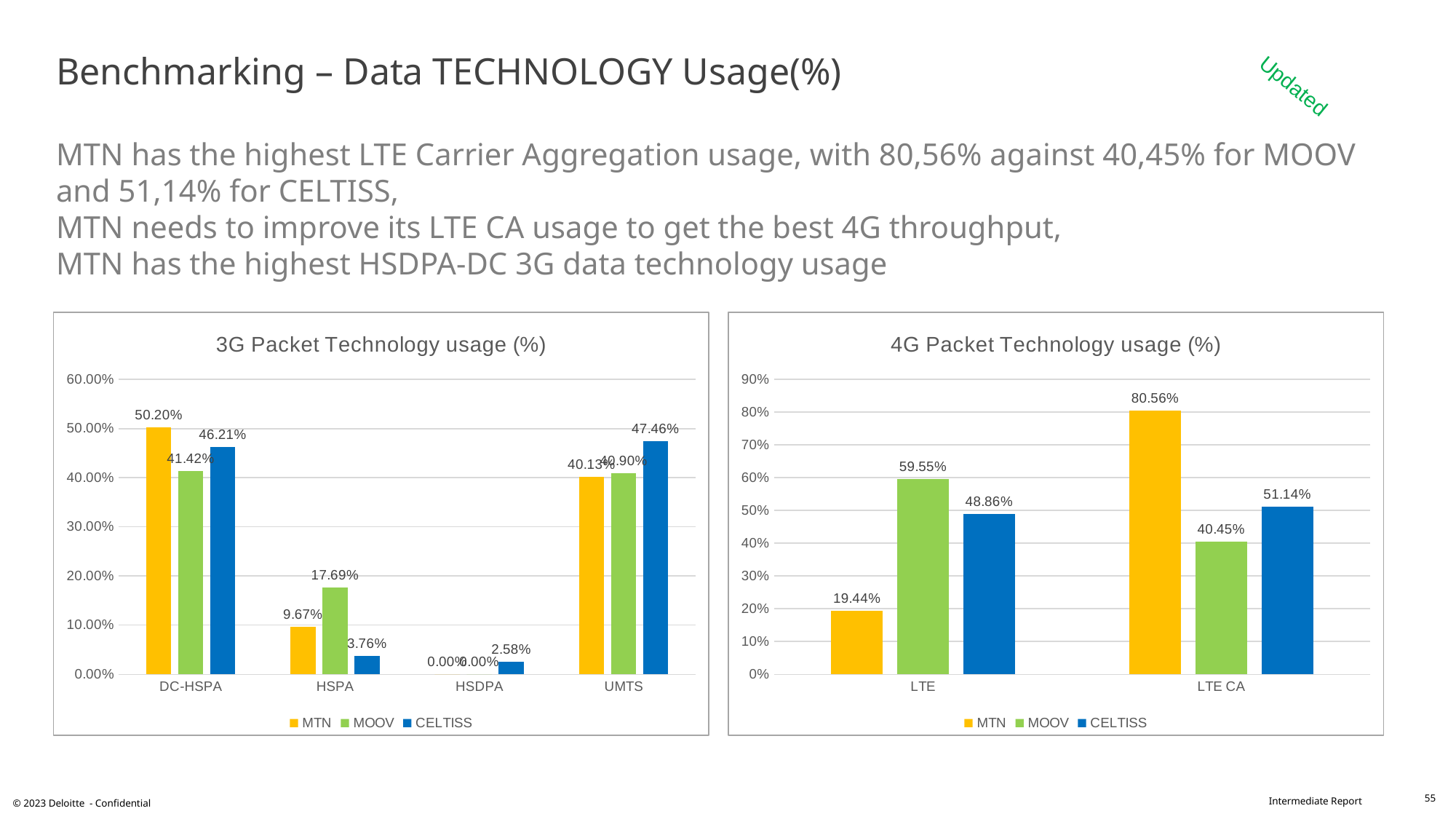
In the 3G Packet Technology usage (%) chart, how many categories are shown on the x axis? 4 What kind of chart is the 4G Packet Technology usage (%) chart? Bar chart In the 3G Packet Technology usage (%) chart, is the value for MOOV at DC-HSPA greater or less than 40.00%? greater In the 3G Packet Technology usage (%) chart, which operator has the highest value at HSPA? MOOV In the 4G Packet Technology usage (%) chart, which operator has the lowest value at LTE? MTN In the 4G Packet Technology usage (%) chart, which is larger: MOOV at LTE or CELTISS at LTE? MOOV at LTE In the 3G Packet Technology usage (%) chart, what is the value for CELTISS at UMTS? 47.46% In the 3G Packet Technology usage (%) chart, what is the difference between MOOV and CELTISS at HSPA? 13.93% In the 4G Packet Technology usage (%) chart, what is the value for MTN at LTE CA? 80.56% In the 3G Packet Technology usage (%) chart, what is the value for MTN at DC-HSPA? 50.20% How many series does the legend of the 4G Packet Technology usage (%) chart list? 3 In the 4G Packet Technology usage (%) chart, what is the difference between MTN and CELTISS at LTE CA? 29.42%